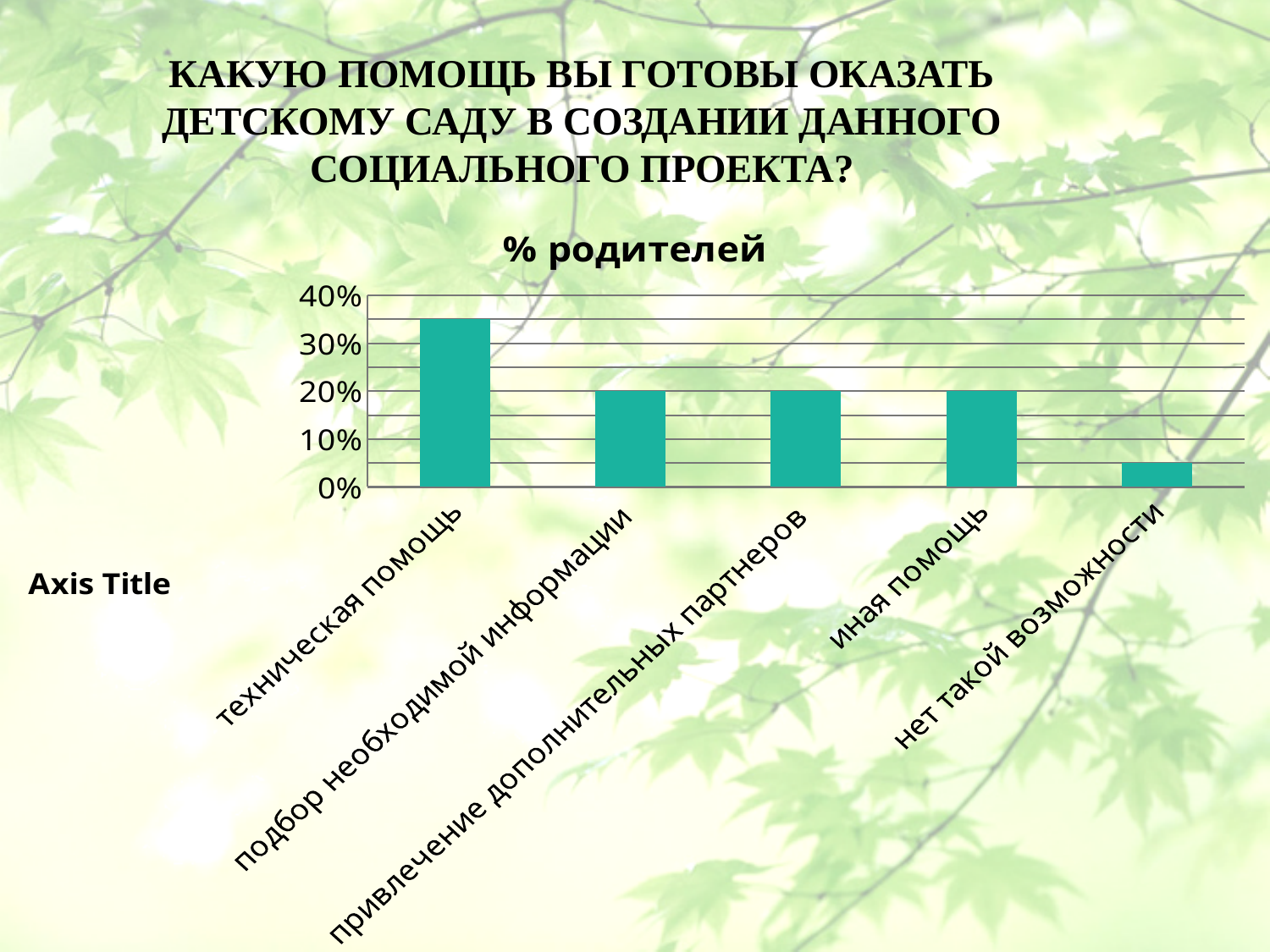
Is the value for 'техническая помощь' greater or less than 30%? greater What is the value for 'иная помощь'? 20% Which category has the highest value in the chart? техническая помощь Is the value for 'нет такой возможности' greater or less than 10%? less What is the title of the chart? % родителей What is the value for 'подбор необходимой информации'? 20% How many categories are plotted on the x axis of the chart? 5 Which category has the lowest value in the chart? нет такой возможности What kind of chart is shown on the slide? bar chart What is the value for 'привлечение дополнительных партнеров'? 20% Which is larger, the value for 'техническая помощь' or the value for 'иная помощь'? техническая помощь What is the difference between the values for 'подбор необходимой информации' and 'иная помощь'? 0%